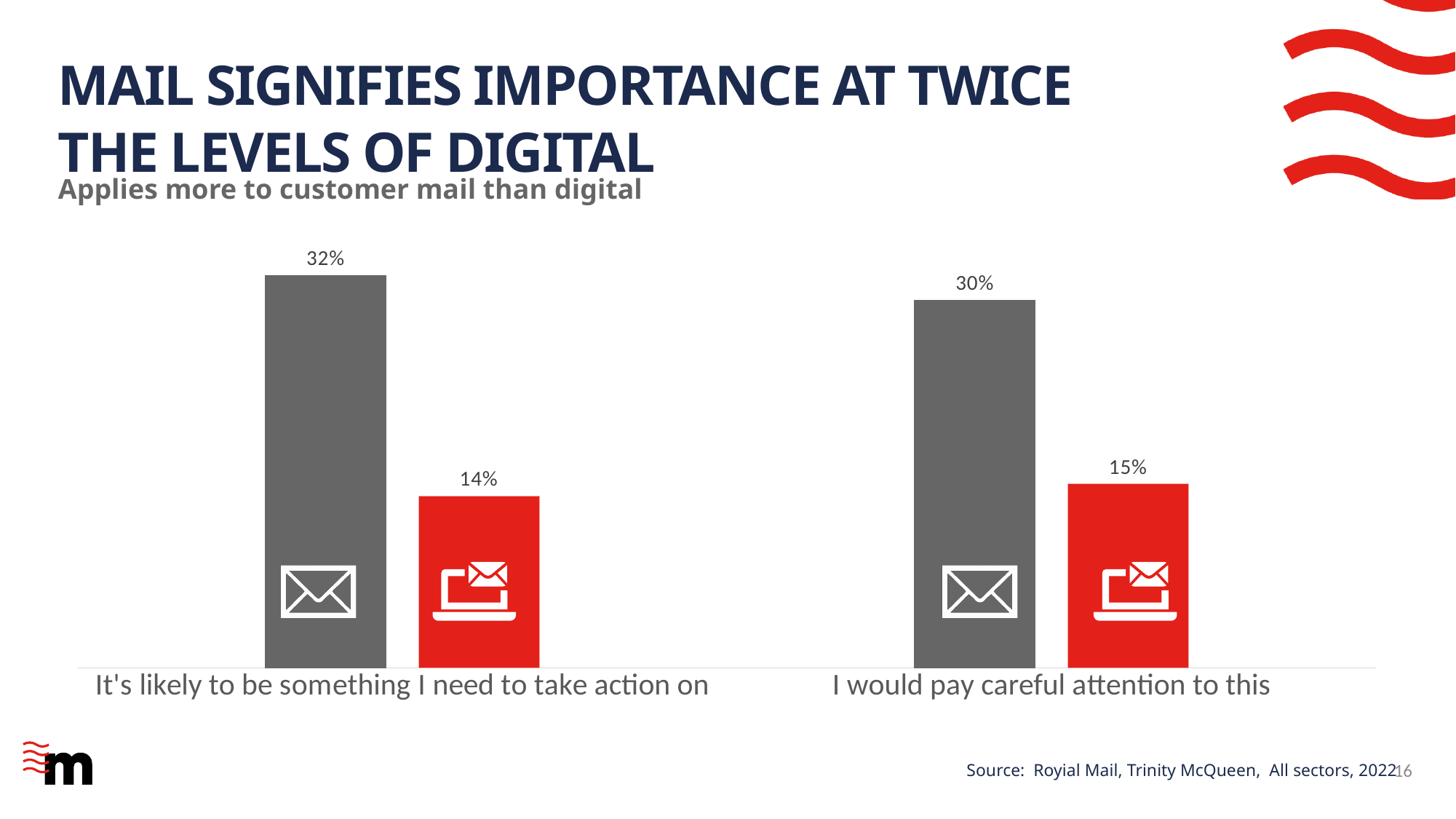
Which bar on the chart has the highest value? Mail (grey) for "It's likely to be something I need to take action on", 32% What value is shown for the red (digital) bar for "It's likely to be something I need to take action on"? 14% What is the difference between the mail and digital values for "I would pay careful attention to this"? 15 percentage points What value is shown for the grey (mail) bar for "I would pay careful attention to this"? 30% What type of chart is shown on the slide? Bar chart How many statement categories are shown on the x axis of the chart? 2 For "I would pay careful attention to this", which is larger: the mail value or the digital value? Mail What value is shown for the red (digital) bar for "I would pay careful attention to this"? 15% What colour are the bars representing digital (laptop icon)? Red What is the difference between the mail and digital values for "It's likely to be something I need to take action on"? 18 percentage points Which bar on the chart has the lowest value? Digital (red) for "It's likely to be something I need to take action on", 14% What value is shown for the grey (mail) bar for "It's likely to be something I need to take action on"? 32%